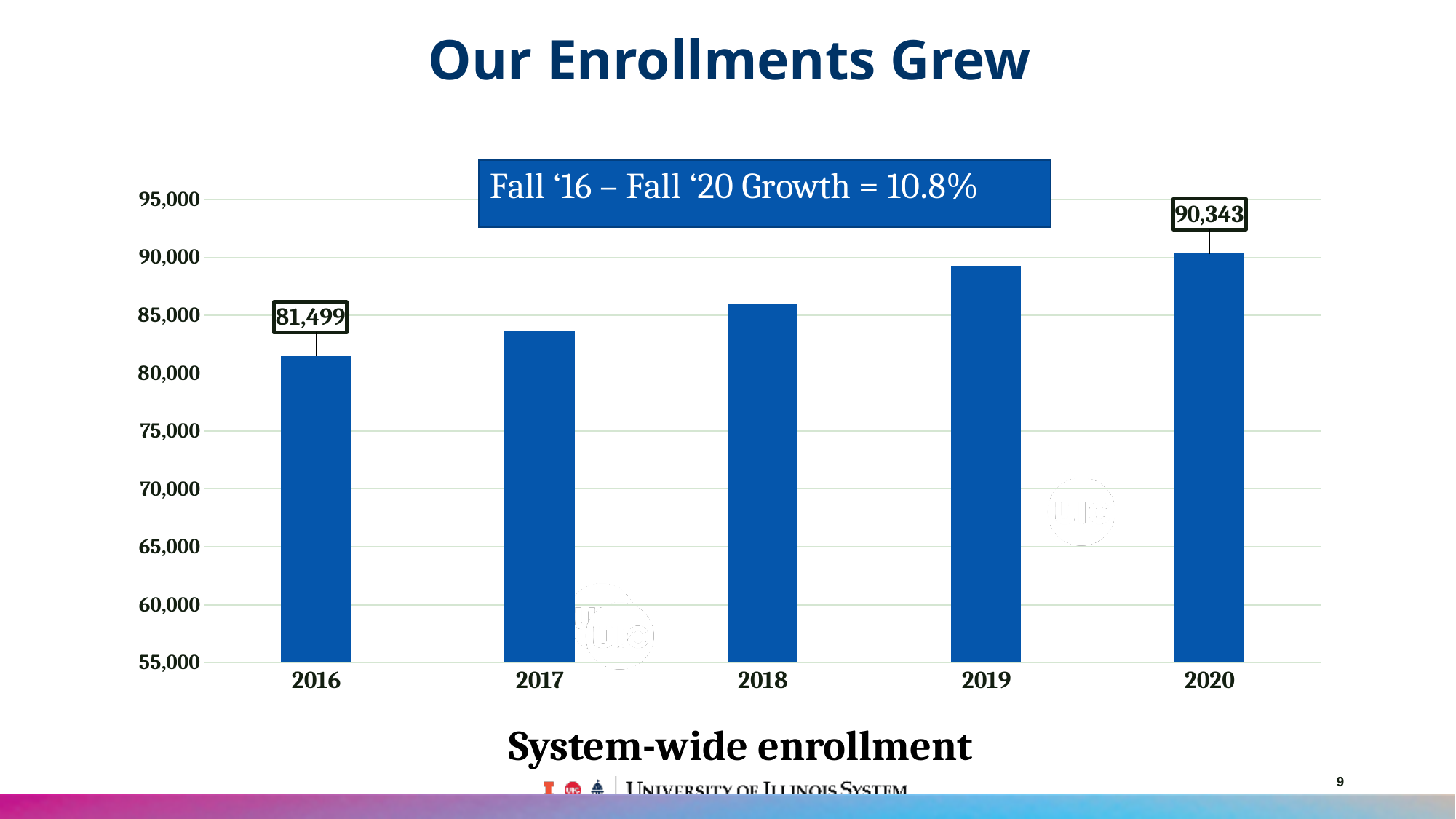
Do the enrollment values rise or fall from 2016 to 2020? Rise What is the system-wide enrollment value shown for 2016? 81,499 Which year has the lowest enrollment? 2016 Which year has the larger enrollment, 2017 or 2019? 2019 Is the value for 2018 greater or less than 85,000? greater What is the system-wide enrollment value shown for 2020? 90,343 How many years are shown on the x axis? 5 What is the difference between the 2020 and 2016 enrollment values? 8,844 What kind of chart is shown on the slide? Bar chart Is the value for 2019 greater or less than 90,000? less Which year has the highest enrollment? 2020 Is the value for 2017 greater or less than 85,000? less